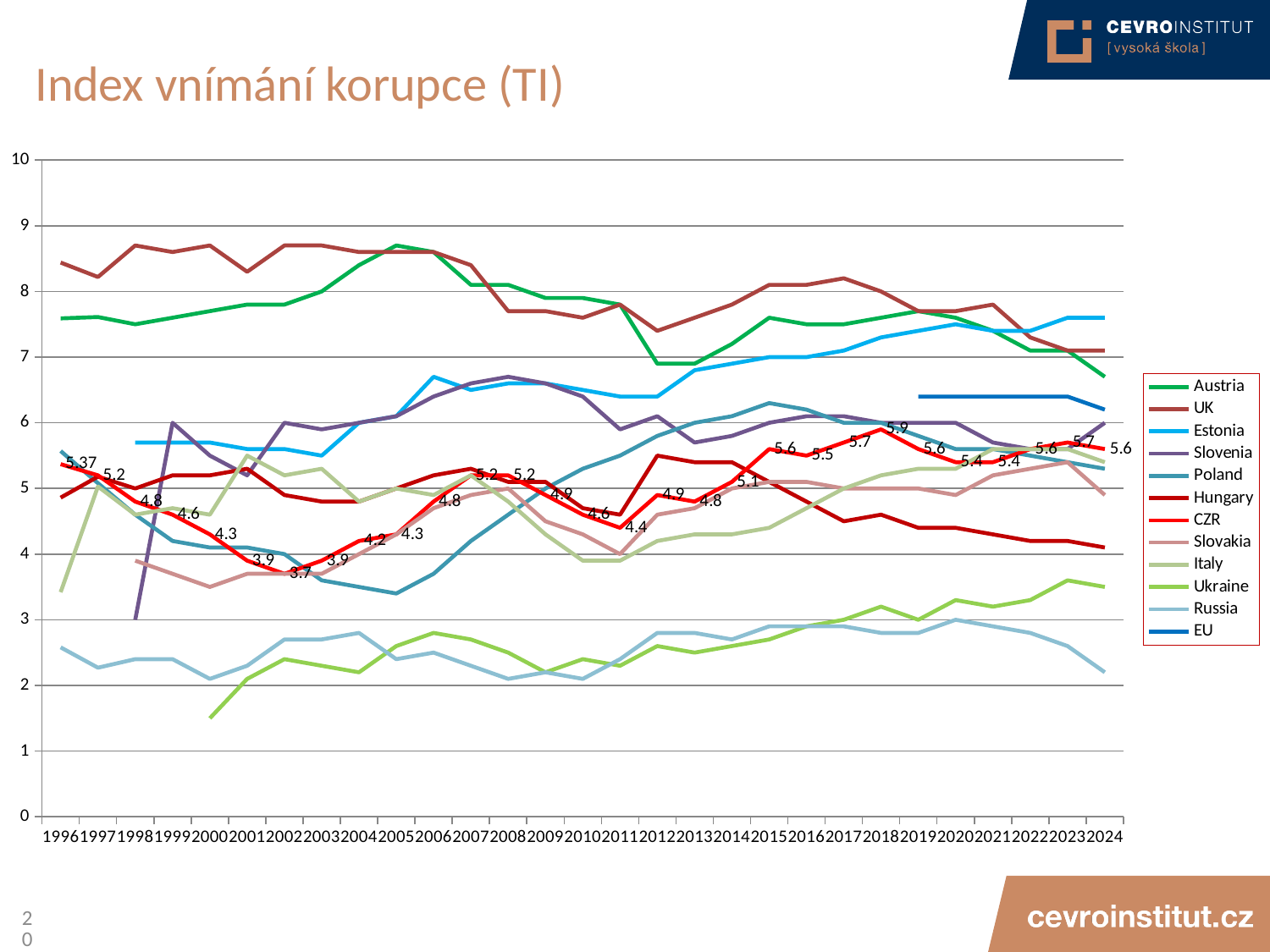
What is the difference between the CZR value in 2018 and in 2002? 2.2 How many series does the legend list? 12 What is the title of the chart? Index vnímání korupce (TI) In which year does the CZR series reach its lowest value? 2002 What kind of chart is shown on the slide? line chart Is the value for Austria in 2024 greater or less than 7? less Which series has the lowest value in 2024? Russia What is the value for CZR in 2018? 5.9 What is the value for CZR in 1996? 5.37 Which series has the highest value in 2024? Estonia What is the value for CZR in 2024? 5.6 In which year does the CZR series reach its highest value? 2018